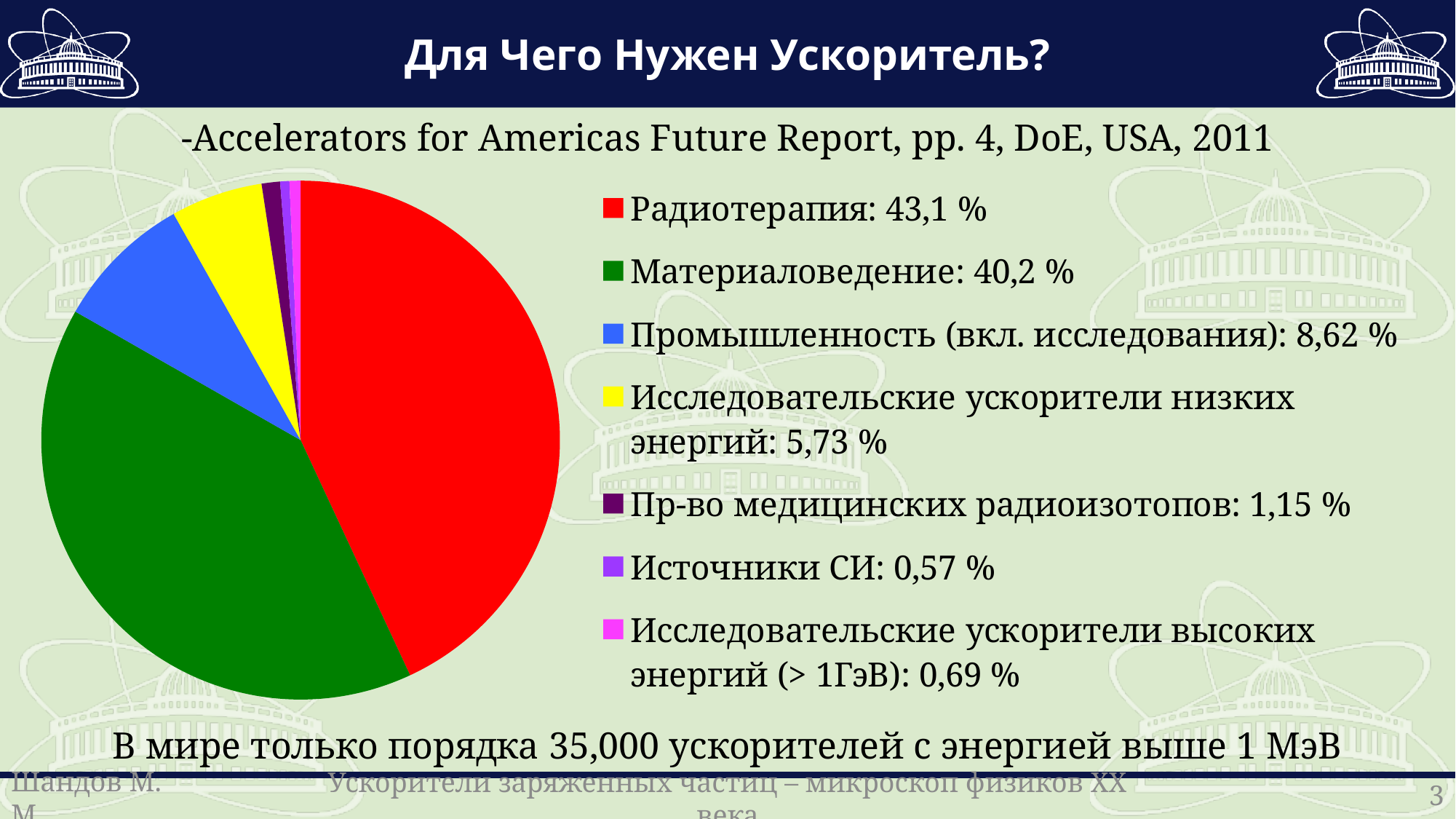
What is the share for Промышленность (вкл. исследования)? 8,62 % What is the share for Материаловедение? 40,2 % Which has the larger share: Пр-во медицинских радиоизотопов or Исследовательские ускорители высоких энергий (> 1ГэВ)? Пр-во медицинских радиоизотопов How many categories does the pie chart have? 7 What kind of chart is shown on the slide? pie chart What is the share for Исследовательские ускорители низких энергий? 5,73 % What colour is the slice for Материаловедение? green What is the share for Радиотерапия? 43,1 % What is the share for Источники СИ? 0,57 % Which category has the largest share of the pie? Радиотерапия Which category has the smallest share of the pie? Источники СИ What is the difference between the shares of Радиотерапия and Материаловедение? 2,9 %